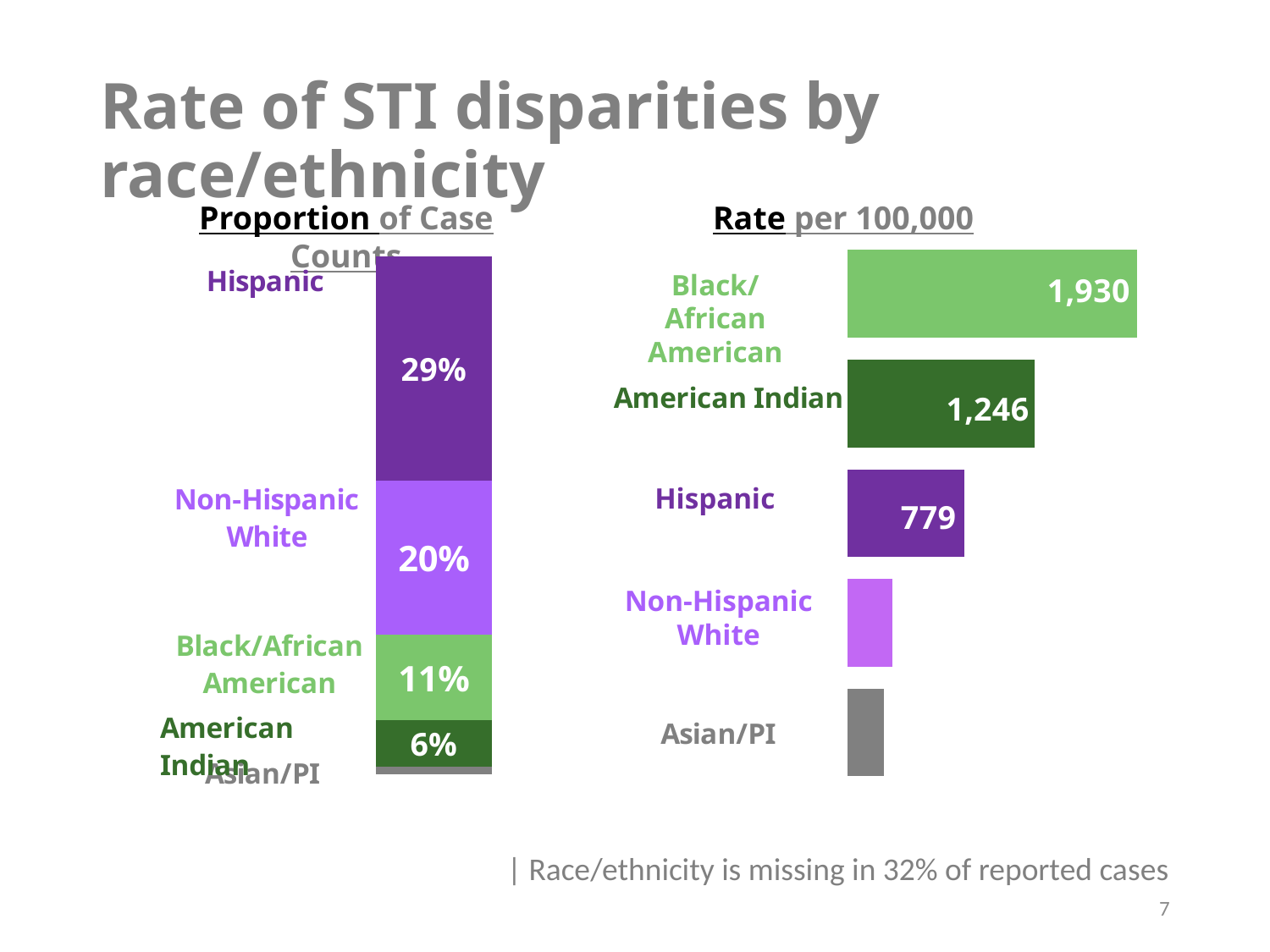
In the 'Proportion of Case Counts' chart, what is the difference between the Black/African American and American Indian proportions? 5% In the 'Rate per 100,000' chart, which group has the highest rate? Black/African American In the 'Rate per 100,000' chart, which is larger: the rate for Hispanic or the rate for Non-Hispanic White? Hispanic In the 'Rate per 100,000' chart, what is the difference between the rates for Black/African American and American Indian? 684 What kind of chart is the 'Rate per 100,000' chart? Bar chart In the 'Rate per 100,000' chart, what is the rate for American Indian? 1,246 In the 'Rate per 100,000' chart, what is the rate for Hispanic? 779 In the 'Proportion of Case Counts' chart, what percentage of cases is Hispanic? 29% In the 'Rate per 100,000' chart, what is the rate for Black/African American? 1,930 In the 'Proportion of Case Counts' chart, what percentage of cases is Non-Hispanic White? 20% In the 'Rate per 100,000' chart, which group has the lowest rate? Asian/PI How many groups are shown in the 'Rate per 100,000' chart? 5